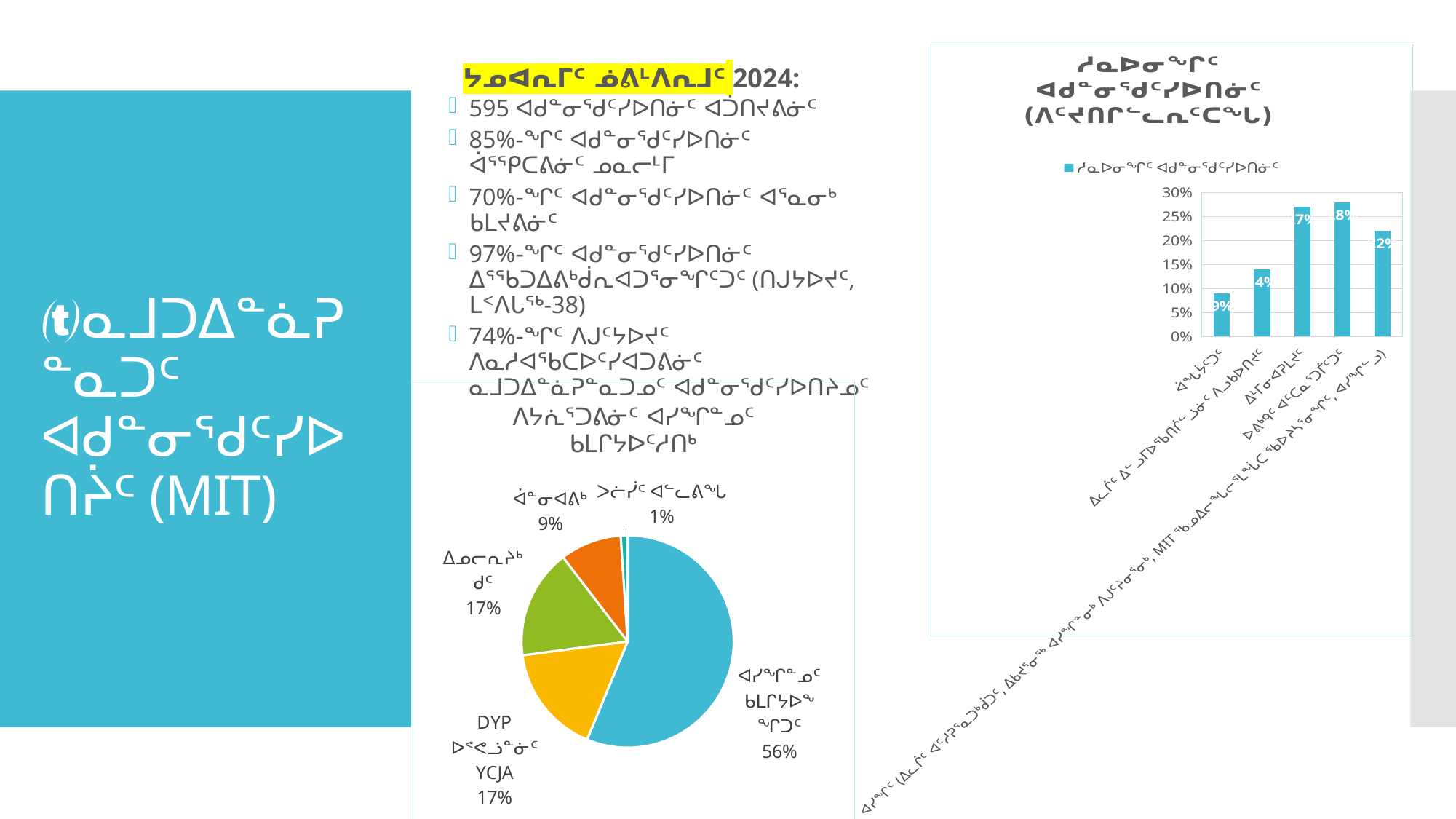
In the pie chart, how many slices are there? 5 In the pie chart, which is larger: the 9% slice or the 1% slice? the 9% slice In the bar chart on the right, how many series does the legend list? 1 In the pie chart, what is the share of the smallest slice? 1% In the pie chart, what share is labelled for the DYP / YCJA slice? 17% In the pie chart, what is the difference in percentage points between the largest slice (56%) and the DYP / YCJA slice (17%)? 39 percentage points What kind of chart is the chart at the bottom centre of the slide? pie chart In the bar chart on the right, is the value of the fourth bar greater or less than 25%? greater In the pie chart, what is the share of the largest slice? 56% What kind of chart is the chart on the right side of the slide? bar chart In the bar chart on the right, is the value of the first (leftmost) bar greater or less than 10%? less In the bar chart on the right, how many bars are plotted? 5